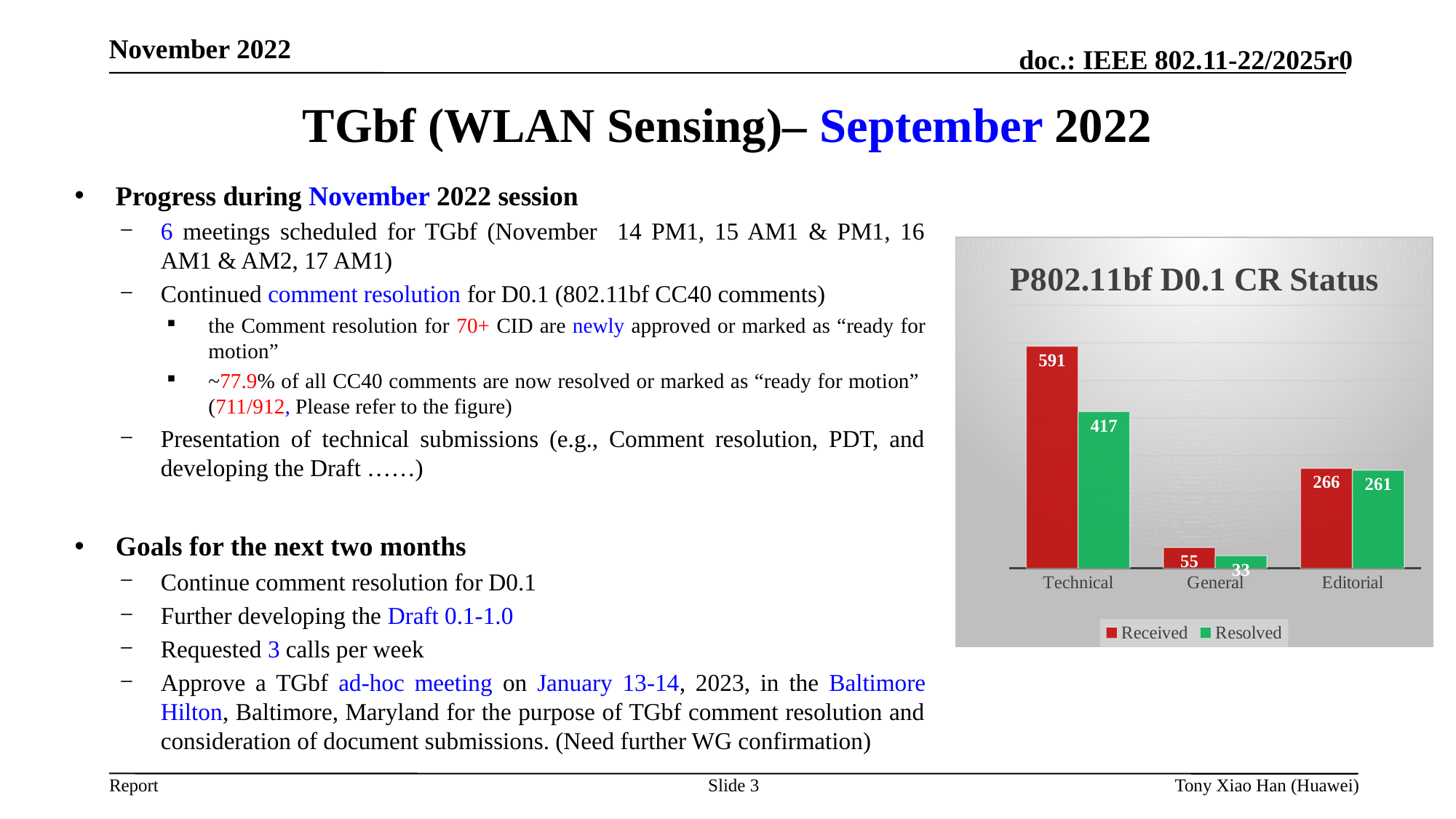
Which is larger for Editorial, Received or Resolved? Received What is the title of the chart on the slide? P802.11bf D0.1 CR Status How many series does the chart legend list? 2 What is the Received value for Technical? 591 What is the Resolved value for Editorial? 261 Which series is shown in red in the chart? Received What type of chart is shown on the slide? bar chart How many categories are shown on the x axis of the chart? 3 Which category has the lowest Resolved value? General Which category has the highest Received value? Technical What is the difference between Received and Resolved for Technical? 174 What is the Resolved value for General? 33